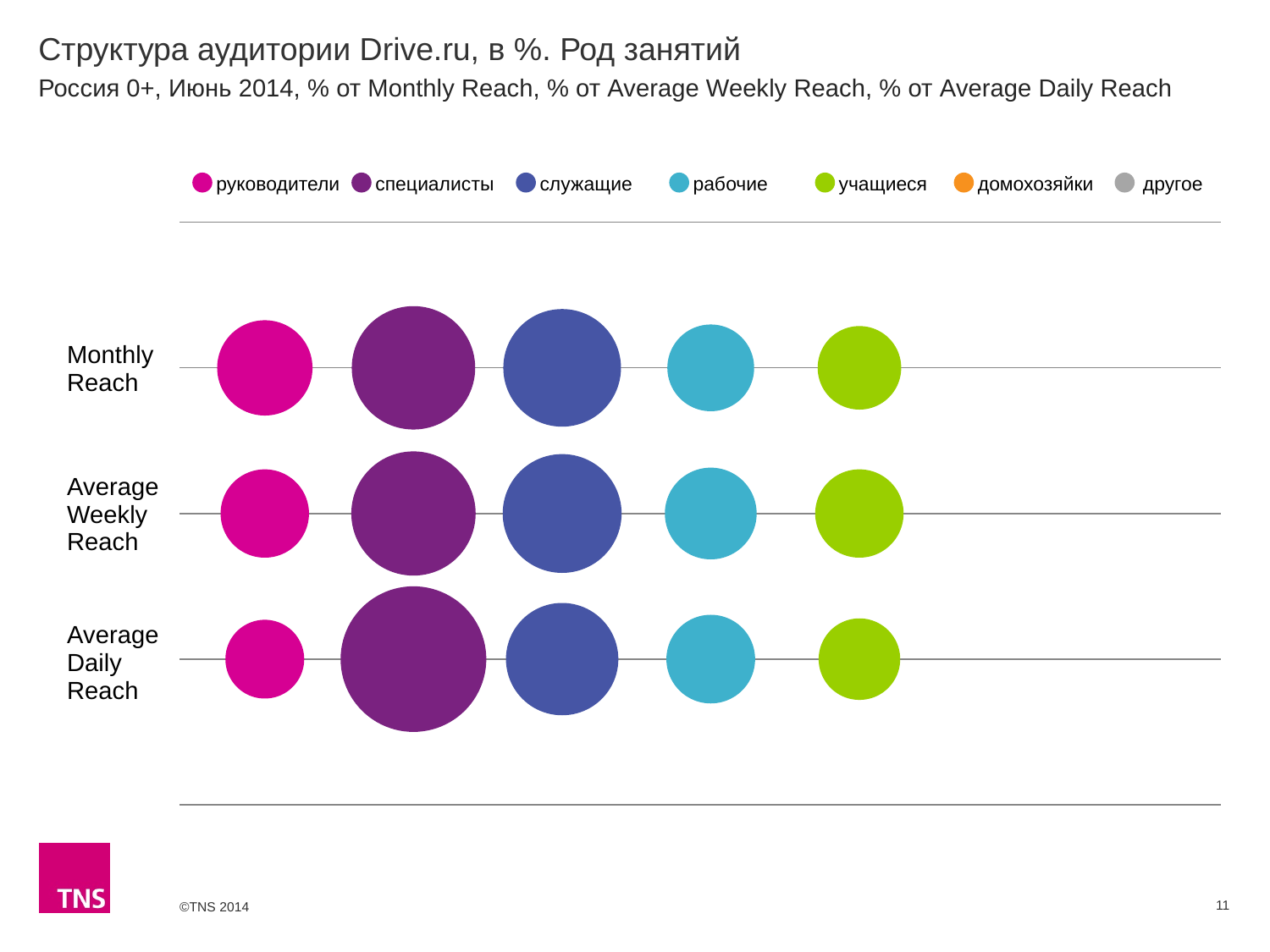
How many reach categories (rows) are plotted on the chart? 3 Which legend entry is shown in orange? домохозяйки Which occupation group has the largest bubble in the Average Daily Reach row? специалисты How many series does the legend list? 7 What kind of chart is shown on the slide? Bubble chart In the Monthly Reach row, which bubble is larger: специалисты or рабочие? специалисты What is the title of the chart on the slide? Структура аудитории Drive.ru, в %. Род занятий In the Average Daily Reach row, which bubble is larger: специалисты or руководители? специалисты Does the bubble for специалисты grow or shrink going from Monthly Reach to Average Daily Reach? grows Which occupation group has the largest bubble in the Monthly Reach row? специалисты Does the bubble for руководители grow or shrink going from Monthly Reach to Average Daily Reach? shrinks